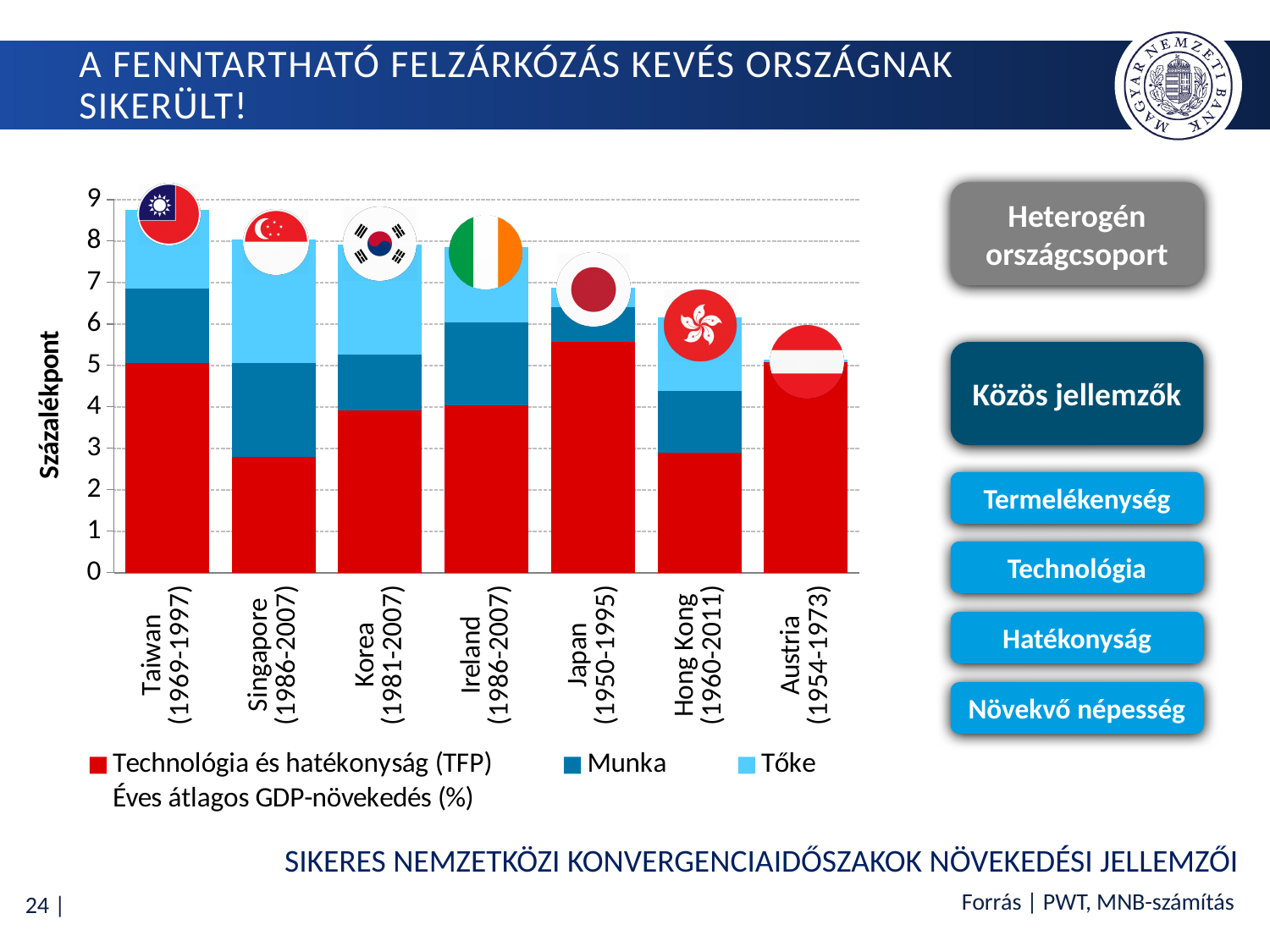
Which country has the shortest stacked bar in the chart? Austria (1954-1973) Is the total height of the bar for Taiwan (1969-1997) greater or less than 8? greater Is the total height of the bar for Austria (1954-1973) greater or less than 6? less How many countries are shown on the x axis of the chart? 7 Which has the taller stacked bar, Japan (1950-1995) or Hong Kong (1960-2011)? Japan (1950-1995) Is the 'Technológia és hatékonyság (TFP)' value for Singapore (1986-2007) greater or less than 3? less Which country has the tallest stacked bar in the chart? Taiwan (1969-1997) What kind of chart is shown on the slide? Stacked bar chart Which country has the largest red 'Technológia és hatékonyság (TFP)' segment? Japan (1950-1995) Do the total bar heights rise or fall moving from left to right along the x axis? fall How many entries does the chart's legend list? 4 What is the label on the vertical axis of the chart? Százalékpont